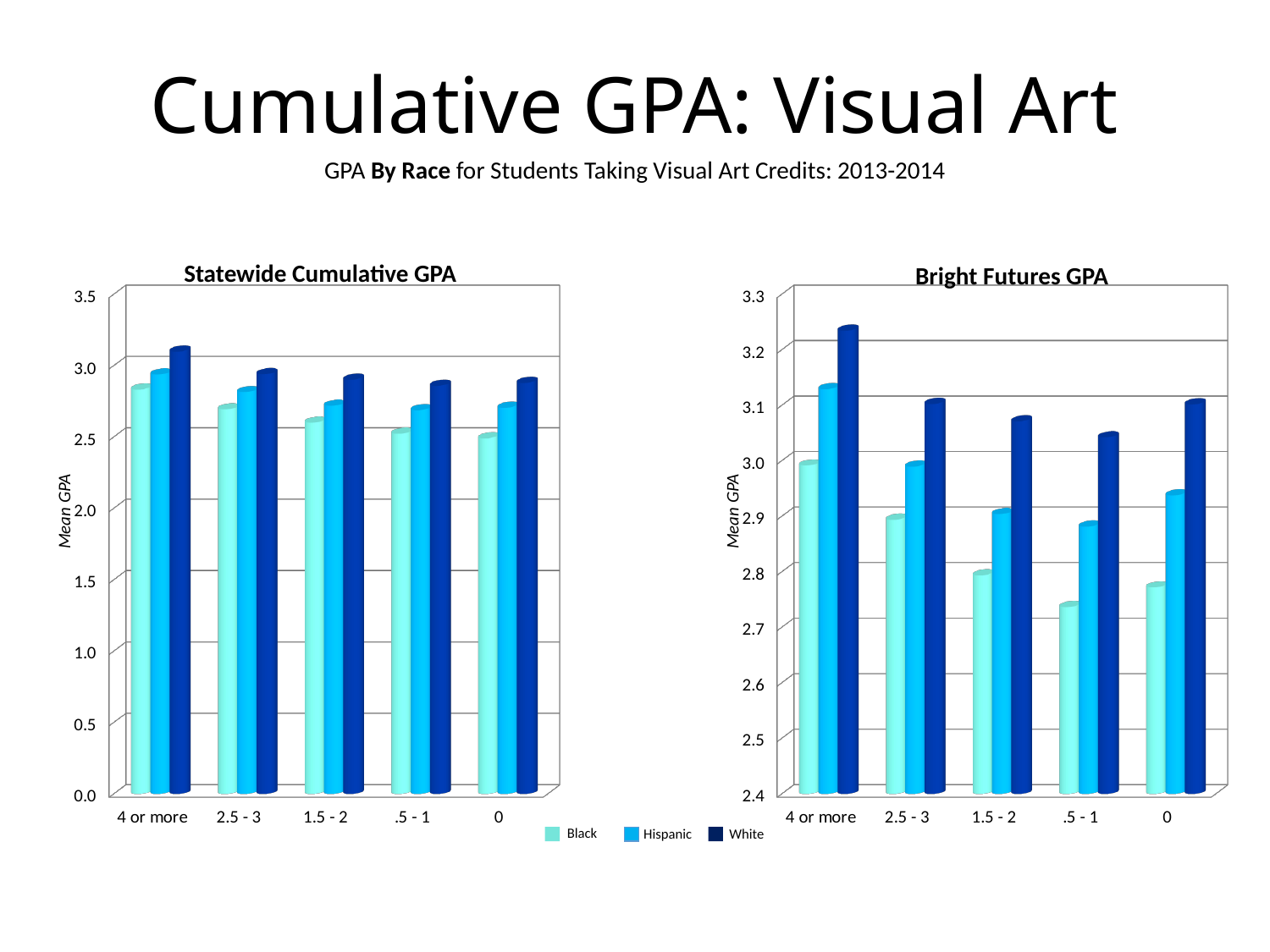
In the Bright Futures GPA chart, which is larger: the Hispanic value for '4 or more' or the Hispanic value for '0'? 4 or more In the Statewide Cumulative GPA chart, is the White value for '4 or more' greater or less than 3.0? greater In the Bright Futures GPA chart, is the Black value for '.5 - 1' greater or less than 2.8? less What kind of chart is the Statewide Cumulative GPA chart? bar chart In the Statewide Cumulative GPA chart, is the Hispanic value for '4 or more' greater or less than 3.0? less In the Statewide Cumulative GPA chart, which series has the highest bar in the '4 or more' category? White How many categories are shown on the x axis of the Bright Futures GPA chart? 5 What is the label on the vertical axis of the Bright Futures GPA chart? Mean GPA How many series does the legend list for the charts on this slide? 3 In the Statewide Cumulative GPA chart, do the Black values rise or fall moving from '4 or more' to '0' along the x axis? fall In the Bright Futures GPA chart, which category has the lowest Black bar? .5 - 1